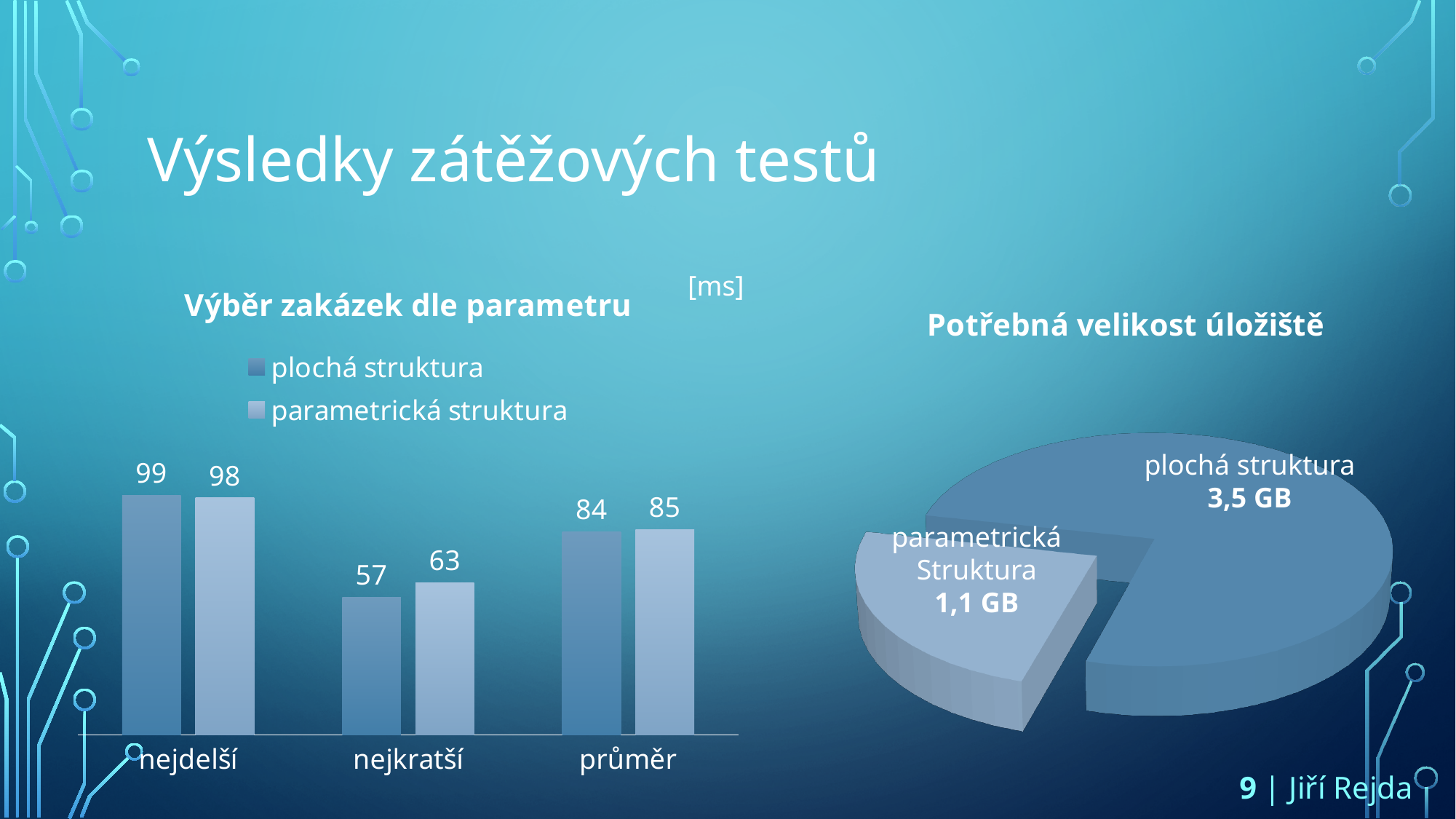
In the chart 'Výběr zakázek dle parametru', which category has the lowest value for 'plochá struktura'? nejkratší In the chart 'Výběr zakázek dle parametru', what is the difference between 'parametrická struktura' and 'plochá struktura' in the 'nejkratší' category? 6 In the chart 'Výběr zakázek dle parametru', what is the value for 'parametrická struktura' in the 'průměr' category? 85 In the chart 'Výběr zakázek dle parametru', which is larger in the 'nejkratší' category: 'plochá struktura' or 'parametrická struktura'? parametrická struktura What kind of chart is 'Potřebná velikost úložiště'? pie chart In the chart 'Výběr zakázek dle parametru', what is the value for 'parametrická struktura' in the 'nejkratší' category? 63 In the chart 'Výběr zakázek dle parametru', which category has the highest value for 'parametrická struktura'? nejdelší How many categories are shown on the x axis of the chart 'Výběr zakázek dle parametru'? 3 How many series does the legend of the chart 'Výběr zakázek dle parametru' list? 2 In the chart 'Potřebná velikost úložiště', what is the value for 'plochá struktura'? 3,5 GB In the chart 'Výběr zakázek dle parametru', what is the value for 'plochá struktura' in the 'nejdelší' category? 99 In the chart 'Potřebná velikost úložiště', which slice is larger: 'plochá struktura' or 'parametrická struktura'? plochá struktura